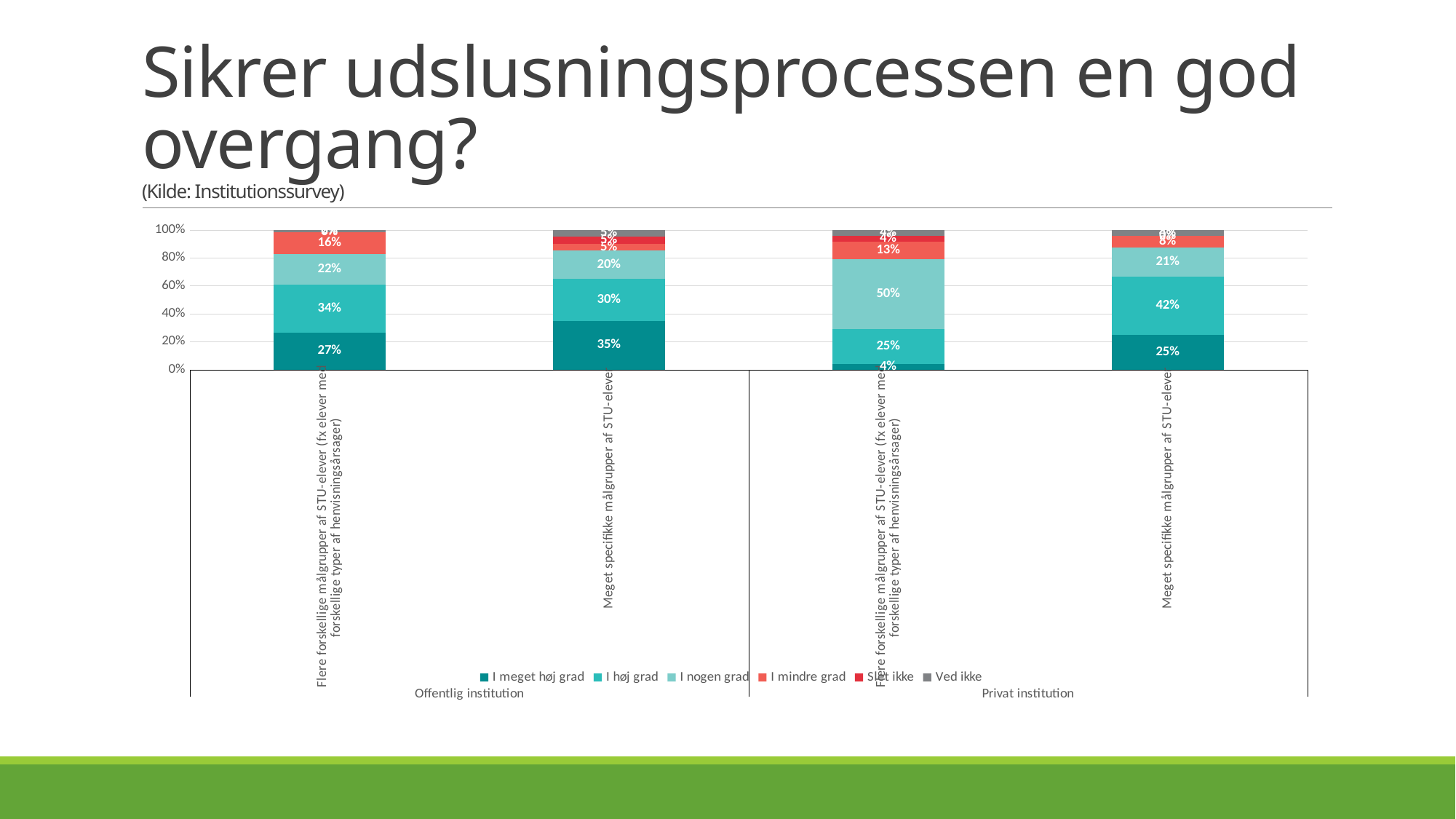
For 'Offentlig institution', what is the 'I mindre grad' share for 'Flere forskellige målgrupper af STU-elever'? 16% Which legend entry is shown in the darkest teal colour? I meget høj grad For 'Privat institution', what is the 'I nogen grad' share for 'Flere forskellige målgrupper af STU-elever'? 50% For 'Offentlig institution', what is the 'I høj grad' share for 'Meget specifikke målgrupper af STU-elever'? 30% What is the difference between the 'I nogen grad' share for 'Flere forskellige målgrupper af STU-elever' at 'Privat institution' (50%) and at 'Offentlig institution' (22%)? 28 percentage points For 'Offentlig institution', what is the 'I meget høj grad' share for 'Flere forskellige målgrupper af STU-elever'? 27% How many series does the legend list? 6 How many bars are plotted in the chart? 4 For 'Privat institution', what is the 'I høj grad' share for 'Meget specifikke målgrupper af STU-elever'? 42% What kind of chart is shown on the slide? stacked bar chart Which is larger: the 'I meget høj grad' share for 'Meget specifikke målgrupper af STU-elever' at 'Offentlig institution' or at 'Privat institution'? Offentlig institution For 'Privat institution', what is the 'I meget høj grad' share for 'Flere forskellige målgrupper af STU-elever'? 4%